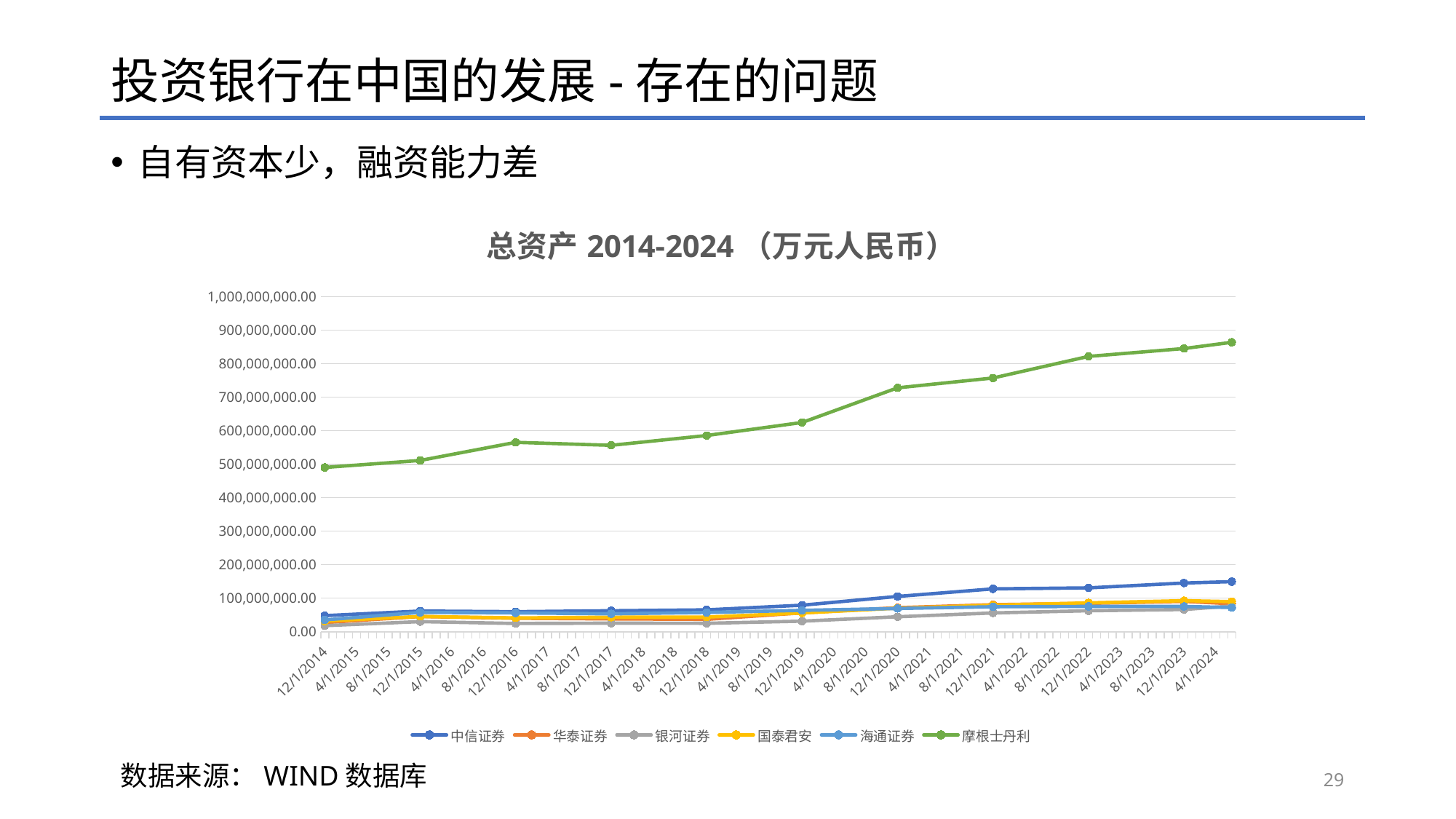
Does the 摩根士丹利 line generally rise or fall from 12/1/2014 to 4/1/2024? rise Is the value for 中信证券 at 4/1/2024 greater or less than 200,000,000.00? less Which series has the second-highest value at 4/1/2024? 中信证券 Which series has the highest values throughout the chart? 摩根士丹利 At 4/1/2024, which is larger: 摩根士丹利 or 中信证券? 摩根士丹利 How many series does the legend list? 6 Is the value for 摩根士丹利 at 4/1/2024 greater or less than 800,000,000.00? greater Is the value for 摩根士丹利 at 12/1/2014 greater or less than 600,000,000.00? less Which series is listed first in the legend? 中信证券 What kind of chart is shown on the slide? line chart What is the title of the chart? 总资产 2014-2024 （万元人民币）